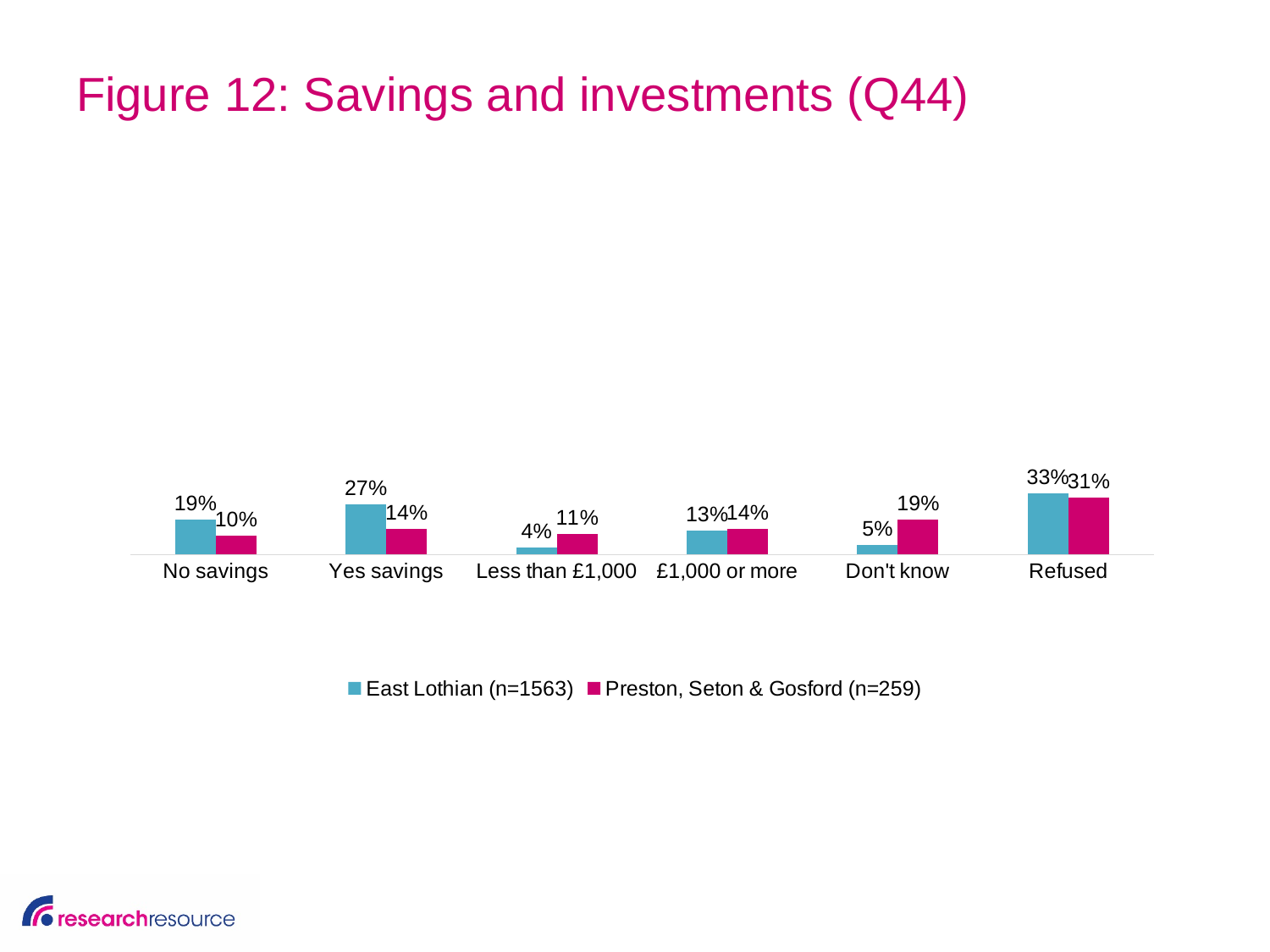
What is the East Lothian value for 'Less than £1,000'? 4% For 'Don't know', which series has the larger value: East Lothian or Preston, Seton & Gosford? Preston, Seton & Gosford Which category has the lowest East Lothian value? Less than £1,000 Which category has the highest East Lothian value? Refused What is the East Lothian value for 'No savings'? 19% How many categories are shown on the x axis? 6 What is the Preston, Seton & Gosford value for 'Don't know'? 19% What is the difference between the East Lothian and Preston, Seton & Gosford values for 'Yes savings'? 13 percentage points What kind of chart is shown on the slide? Bar chart What is the sample size (n) for East Lothian shown in the legend? 1563 How many series does the legend list? 2 What is the Preston, Seton & Gosford value for 'Refused'? 31%